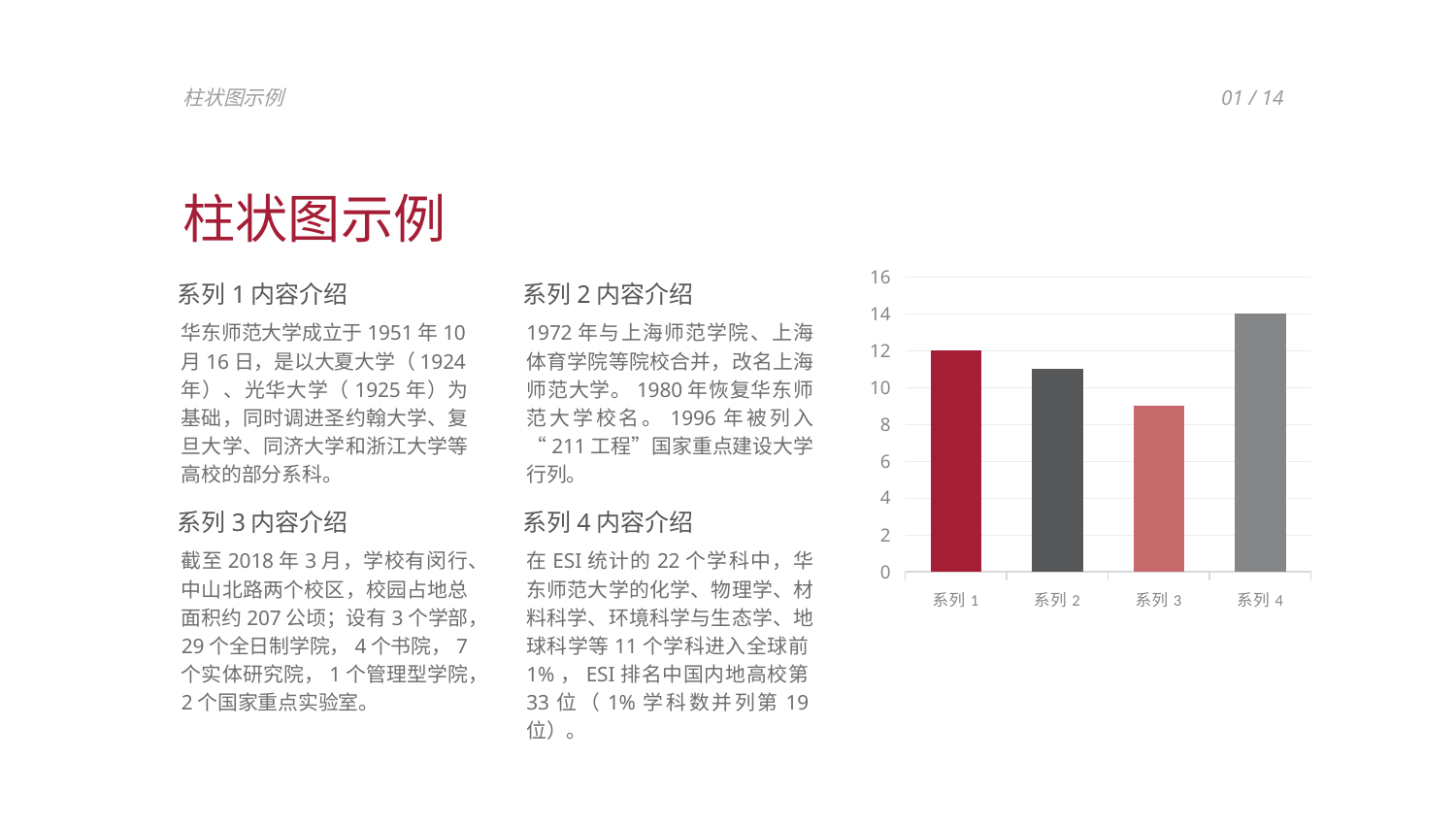
What type of chart is shown on the slide? Bar chart Is the value for 系列 2 greater or less than 10? greater What is the difference between the values for 系列 4 and 系列 1? 2 What colour is the bar for 系列 1? Dark red Is the value for 系列 3 greater or less than 10? less What is the highest value shown on the vertical axis? 16 Which category has the lowest bar? 系列 3 What is the value of the bar for 系列 4? 14 Which is larger, the value for 系列 4 or the value for 系列 3? 系列 4 Which category has the highest bar? 系列 4 How many bars (categories) are plotted in the chart? 4 What is the value of the bar for 系列 1? 12